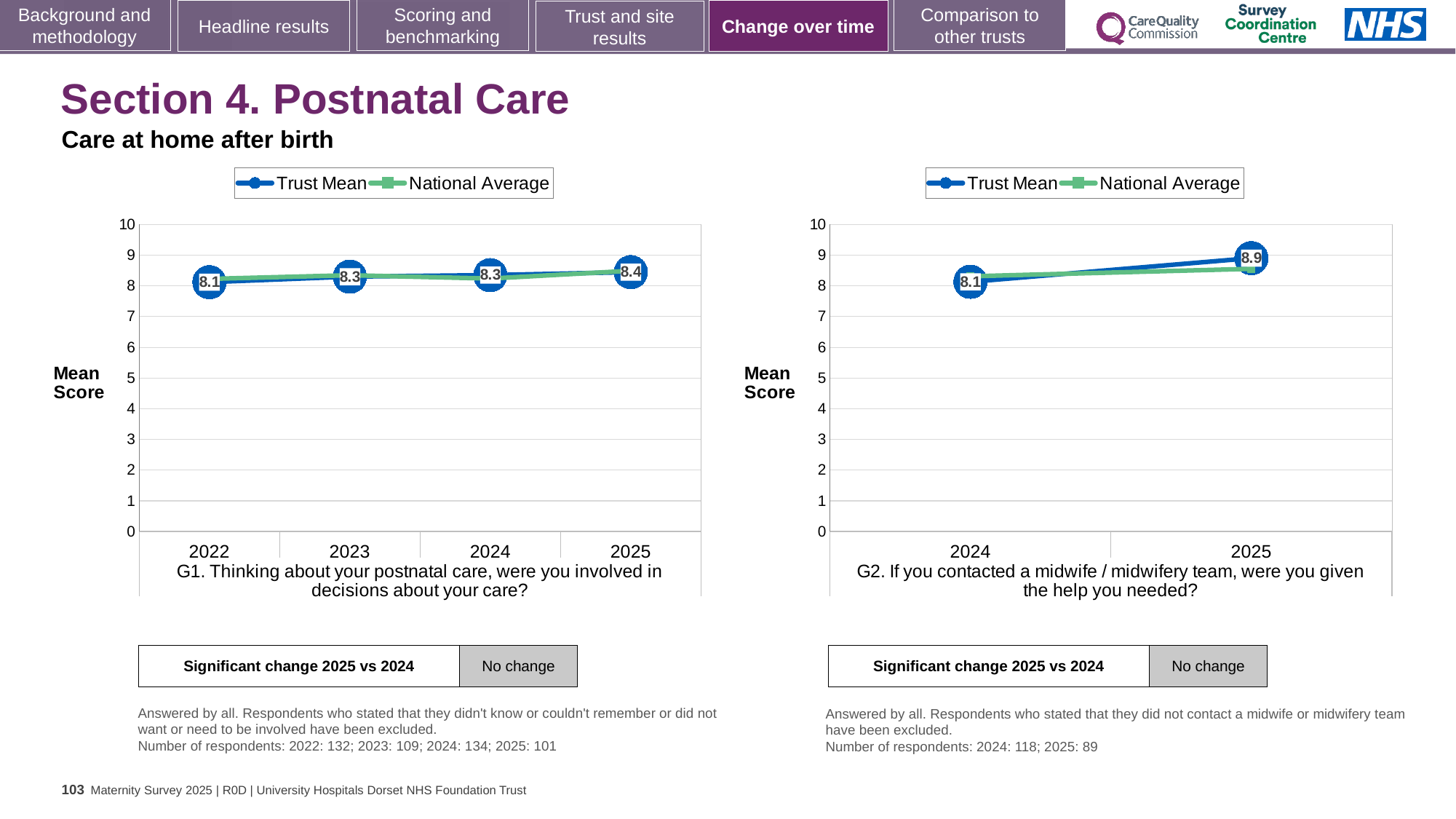
On the G1 chart (left), what is the difference between the Trust Mean scores for 2025 and 2022? 0.3 On the G2 chart (right), what is the Trust Mean score for 2024? 8.1 How many years are plotted on the G1 chart (left)? 4 On the G1 chart (left), which year has the lowest Trust Mean score? 2022 How many series does the legend of the G2 chart (right) list? 2 On the G2 chart (right), is the Trust Mean score for 2025 greater or less than 8? greater On the G2 chart (right), what is the difference between the Trust Mean scores for 2025 and 2024? 0.8 What kind of chart is the G1 chart (left)? Line chart On the G2 chart (right), what is the Trust Mean score for 2025? 8.9 On the G1 chart (left), what is the Trust Mean score for 2025? 8.4 On the G1 chart (left), which year has the highest Trust Mean score? 2025 On the G1 chart (left), what is the Trust Mean score for 2022? 8.1